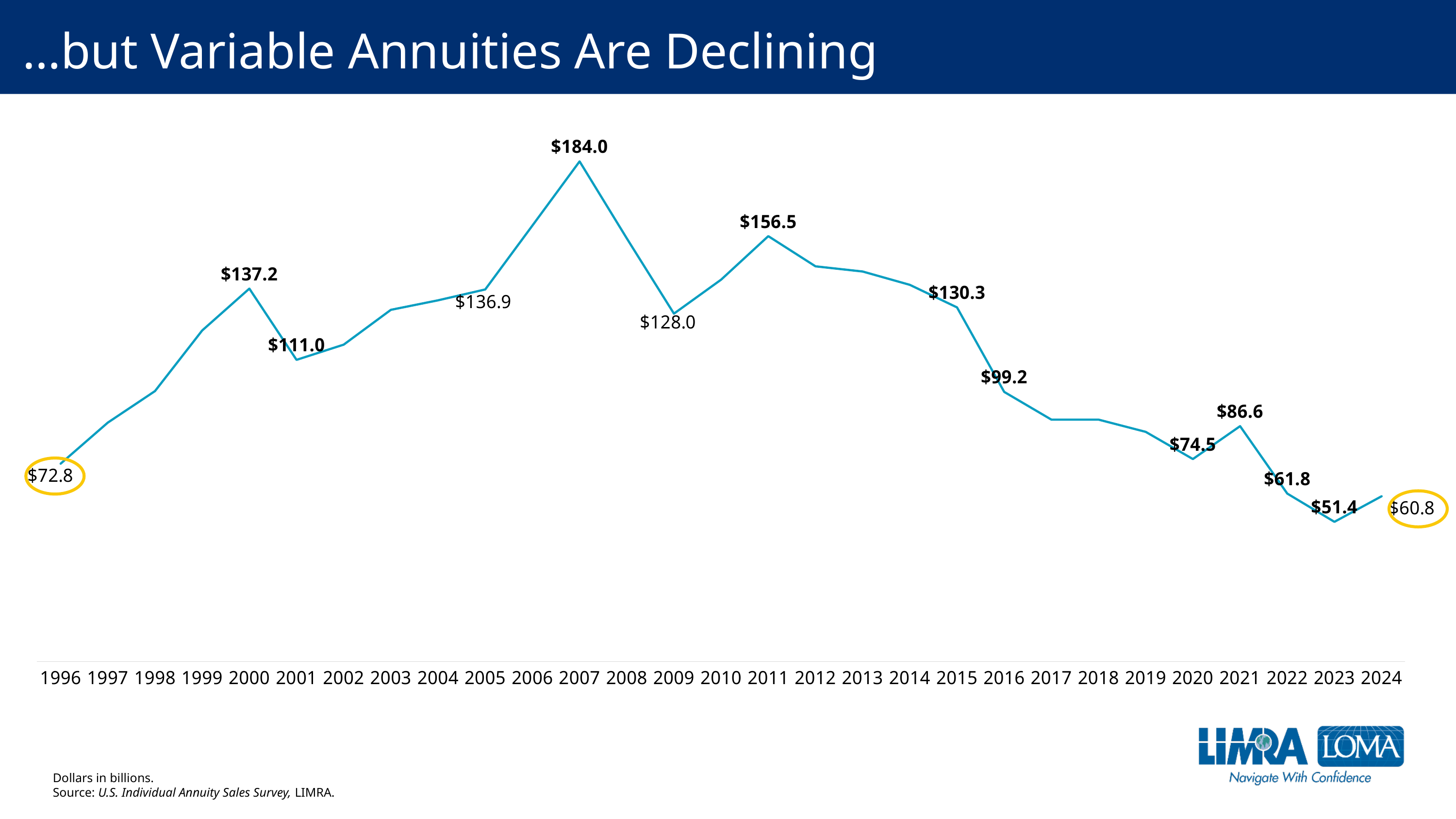
Which is larger, the value for 2000 or the value for 2005? 2000 What was the value for 2007? $184.0 What was the value for 2011? $156.5 What is the difference between the 2007 value and the 2024 value? $123.2 How many years are shown on the x axis? 29 What type of chart is shown on the slide? line chart Which year has the lowest value on the chart? 2023 What was the value for 1996? $72.8 What was the value for 2024? $60.8 Do the values rise or fall from 2021 to 2023? fall What was the value for 2023? $51.4 Which year has the highest value on the chart? 2007